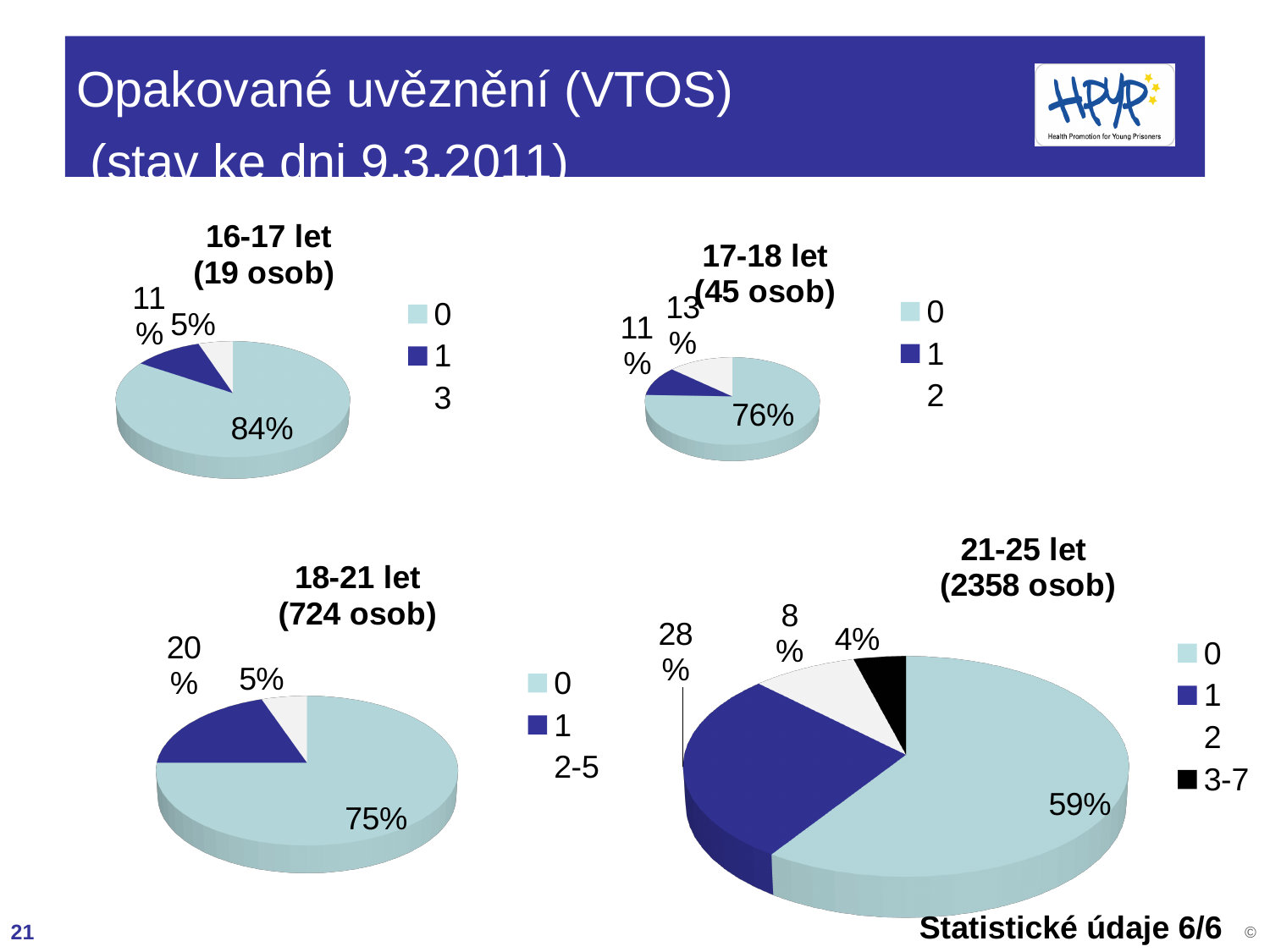
In the "21-25 let (2358 osob)" pie chart, what is the difference between the shares for category 0 and category 1? 31% In the "17-18 let (45 osob)" pie chart, what share is shown for the category 0? 76% In the "21-25 let (2358 osob)" pie chart, which category has the largest slice? 0 In the "18-21 let (724 osob)" pie chart, which is larger, the share for category 1 or for category 2-5? 1 In the "17-18 let (45 osob)" pie chart, what share is shown for the category 2? 13% What type of chart is used for the "16-17 let (19 osob)" data? Pie chart In the "21-25 let (2358 osob)" pie chart, which category has the smallest slice? 3-7 In the "16-17 let (19 osob)" pie chart, what share is shown for the category 0? 84% In the "21-25 let (2358 osob)" pie chart, what share is shown for the category 3-7? 4% How many categories does the legend of the "21-25 let (2358 osob)" chart list? 4 In the "18-21 let (724 osob)" pie chart, what share is shown for the category 1? 20% In the "16-17 let (19 osob)" pie chart, what share is shown for the category 1? 11%